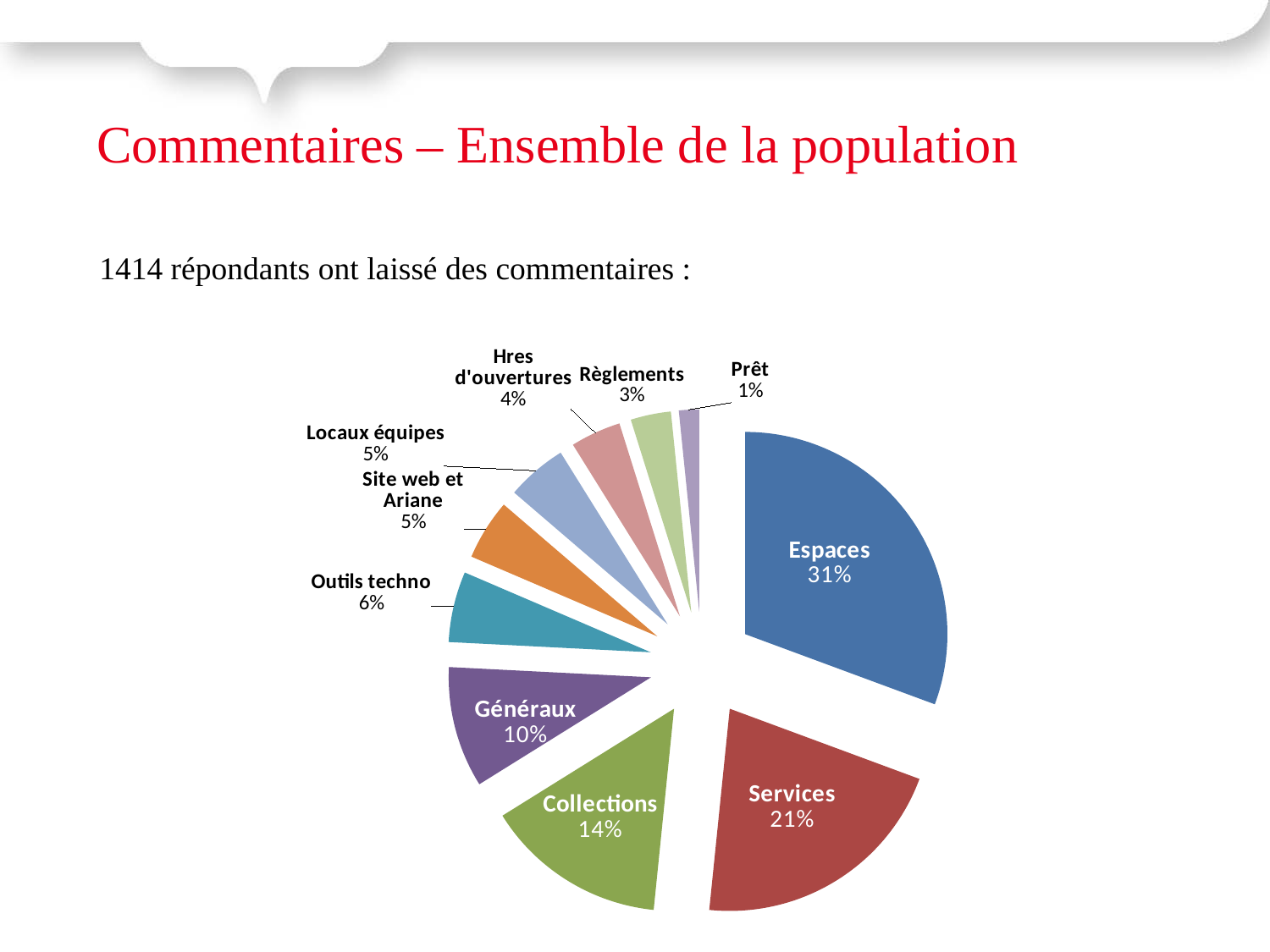
What kind of chart is shown on the slide? Pie chart What share of the pie does Espaces represent? 31% Which is larger, Généraux or Collections? Collections What is the difference in percentage points between Espaces and Services? 10 What percentage is shown for Collections? 14% What percentage is shown for Outils techno? 6% What colour is the Services slice? Red Which category has the smallest slice of the pie? Prêt What percentage is shown for Prêt? 1% How many categories are shown in the pie chart? 10 Which category has the largest slice of the pie? Espaces What percentage is shown for Services? 21%